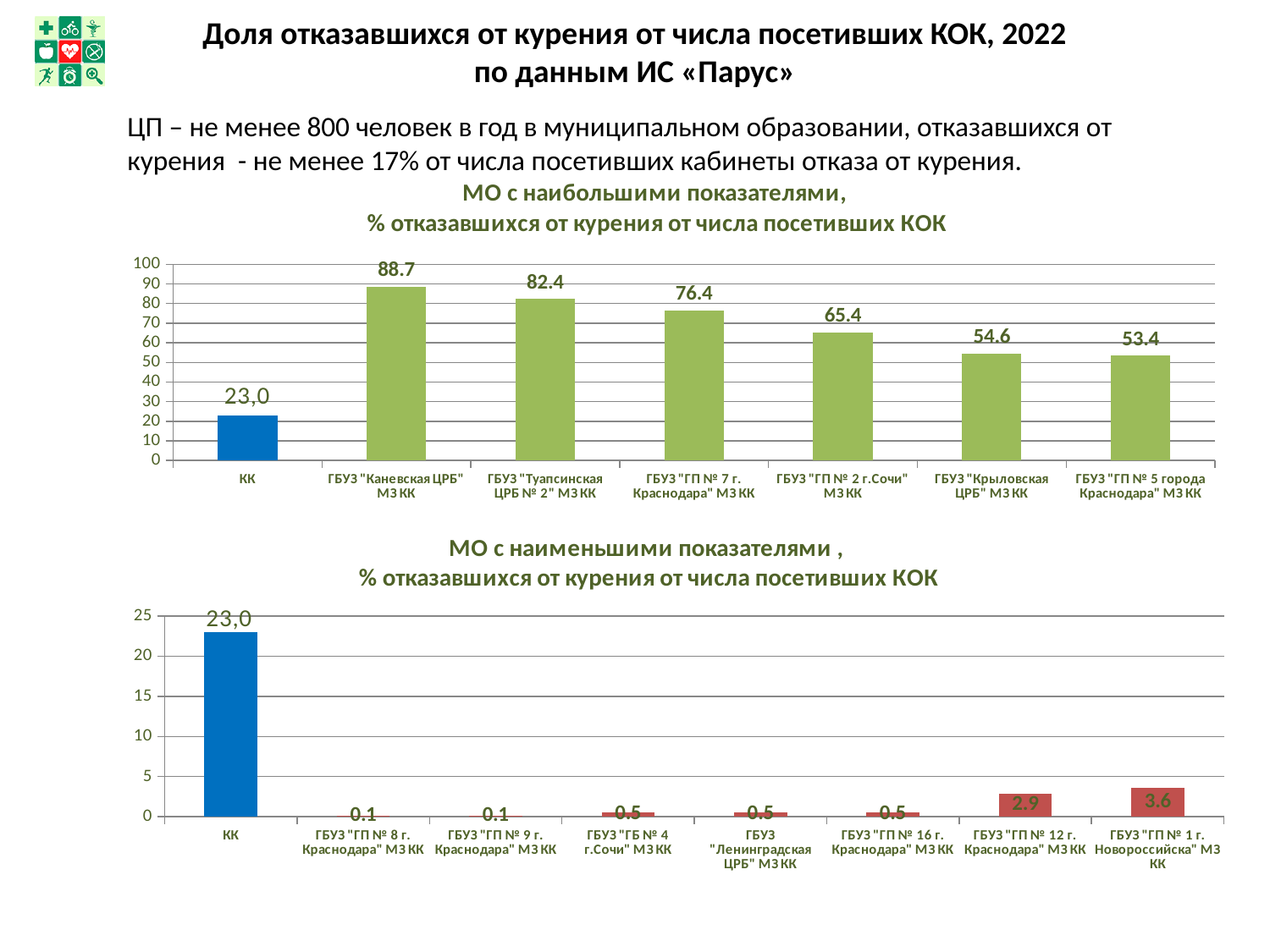
На верхней диаграмме «МО с наибольшими показателями» какая категория имеет наибольшее значение? ГБУЗ "Каневская ЦРБ" МЗ КК На верхней диаграмме «МО с наибольшими показателями» какое значение указано для ГБУЗ "ГП № 2 г.Сочи" МЗ КК? 65.4 На нижней диаграмме «МО с наименьшими показателями» сколько категорий показано? 8 На нижней диаграмме «МО с наименьшими показателями» какое значение указано для ГБУЗ "ГП № 1 г. Новороссийска" МЗ КК? 3.6 Какого типа диаграммы представлены на слайде? Столбчатые (bar chart) На верхней диаграмме «МО с наибольшими показателями» какая категория имеет наименьшее значение? КК На верхней диаграмме «МО с наибольшими показателями» какое значение указано для ГБУЗ "Каневская ЦРБ" МЗ КК? 88.7 На нижней диаграмме «МО с наименьшими показателями» какая категория имеет наибольшее значение? КК На верхней диаграмме «МО с наибольшими показателями» на сколько значение ГБУЗ "Туапсинская ЦРБ № 2" МЗ КК больше значения ГБУЗ "ГП № 7 г. Краснодара" МЗ КК? 6.0 На нижней диаграмме «МО с наименьшими показателями» какое значение указано для ГБУЗ "ГП № 12 г. Краснодара" МЗ КК? 2.9 На верхней диаграмме «МО с наибольшими показателями» сколько категорий показано? 7 На нижней диаграмме «МО с наименьшими показателями» что больше: значение ГБУЗ "ГП № 12 г. Краснодара" МЗ КК или ГБУЗ "ГП № 1 г. Новороссийска" МЗ КК? ГБУЗ "ГП № 1 г. Новороссийска" МЗ КК